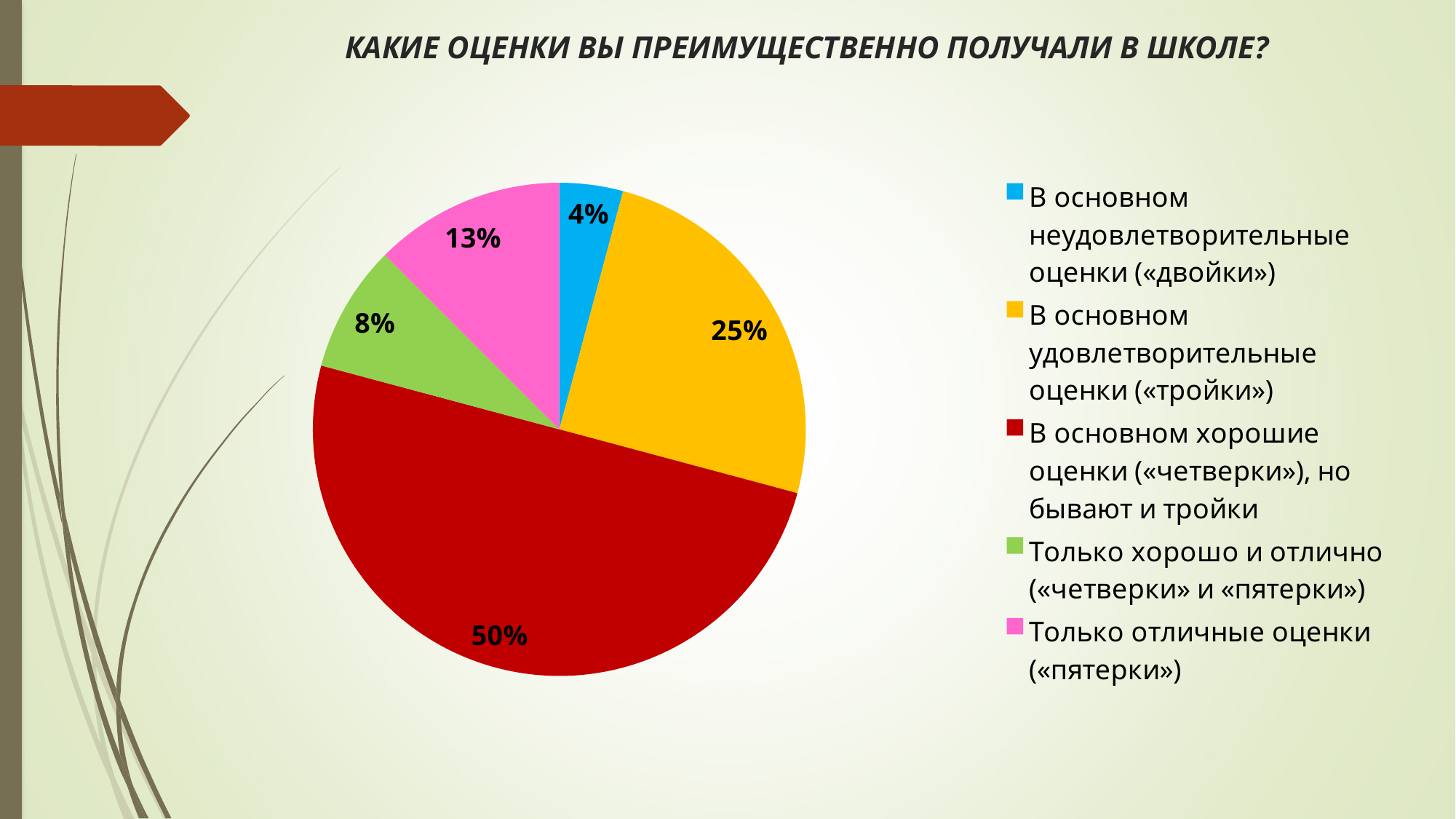
What share of the pie is labelled for «Только хорошо и отлично («четверки» и «пятерки»)»? 8% What share of the pie is labelled for «В основном неудовлетворительные оценки («двойки»)»? 4% What kind of chart is shown on the slide? pie chart What is the difference in percentage points between the «четверки, но бывают и тройки» slice and the «тройки» slice? 25 Which category has the largest slice of the pie? В основном хорошие оценки («четверки»), но бывают и тройки What share of the pie is labelled for «Только отличные оценки («пятерки»)»? 13% What is the title of the chart? КАКИЕ ОЦЕНКИ ВЫ ПРЕИМУЩЕСТВЕННО ПОЛУЧАЛИ В ШКОЛЕ? Which is larger: the slice for «Только отличные оценки («пятерки»)» or the slice for «Только хорошо и отлично («четверки» и «пятерки»)»? Только отличные оценки («пятерки») Which category has the smallest slice of the pie? В основном неудовлетворительные оценки («двойки») How many categories does the legend list? 5